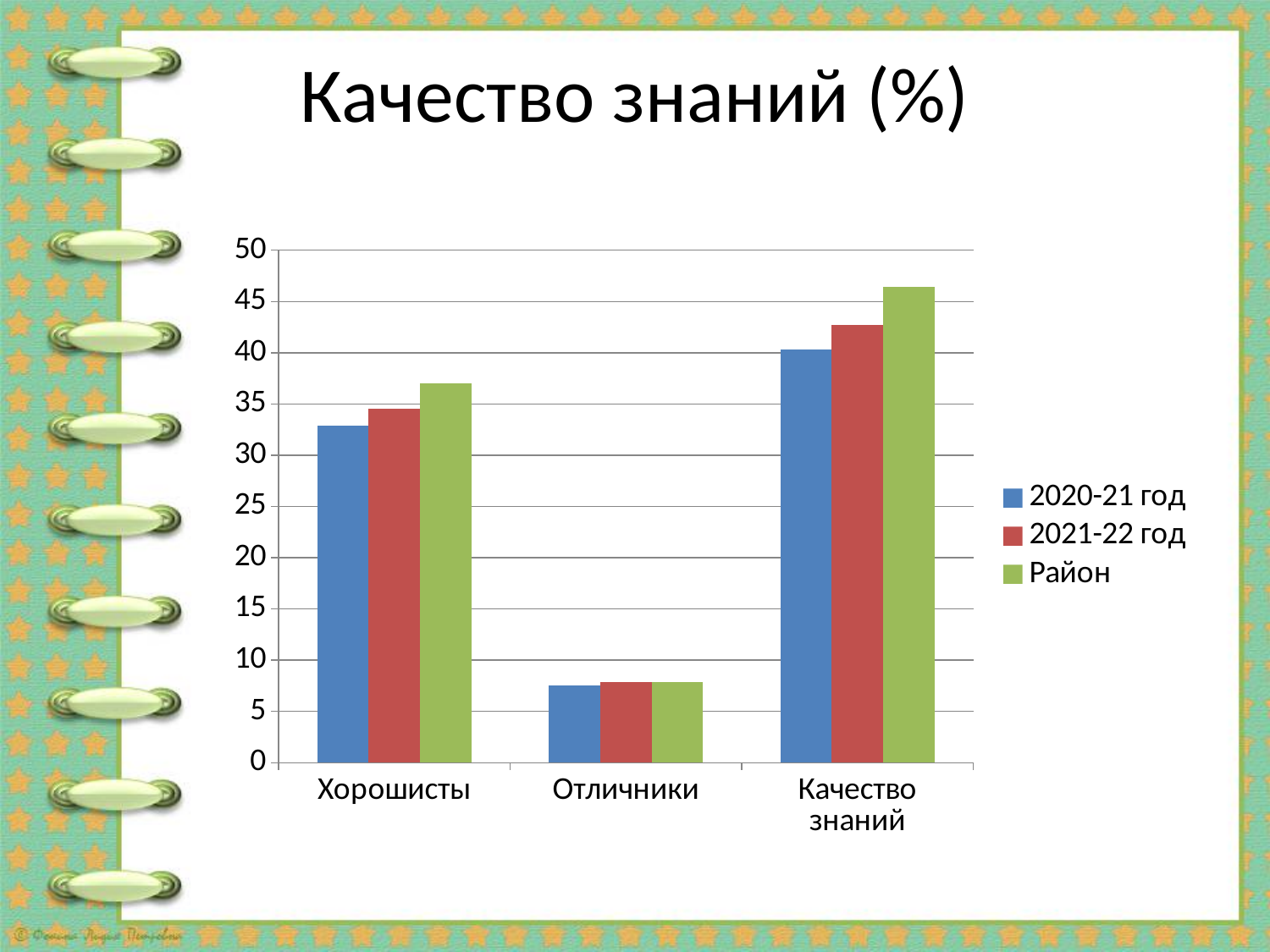
What type of chart is shown on the slide? bar chart Is the value for Отличники in 2021-22 год greater or less than 10? less What is the title of the chart? Качество знаний (%) Which category has the lowest values across all series? Отличники How many series does the legend list? 3 Is the value for Качество знаний for Район greater or less than 45? greater Is the value for Хорошисты for Район greater or less than 35? greater Which bar is the tallest in the whole chart? Район for Качество знаний Which series is shown in green in the legend? Район How many categories are shown on the x axis? 3 For Качество знаний, which is larger: the value for 2020-21 год or for Район? Район